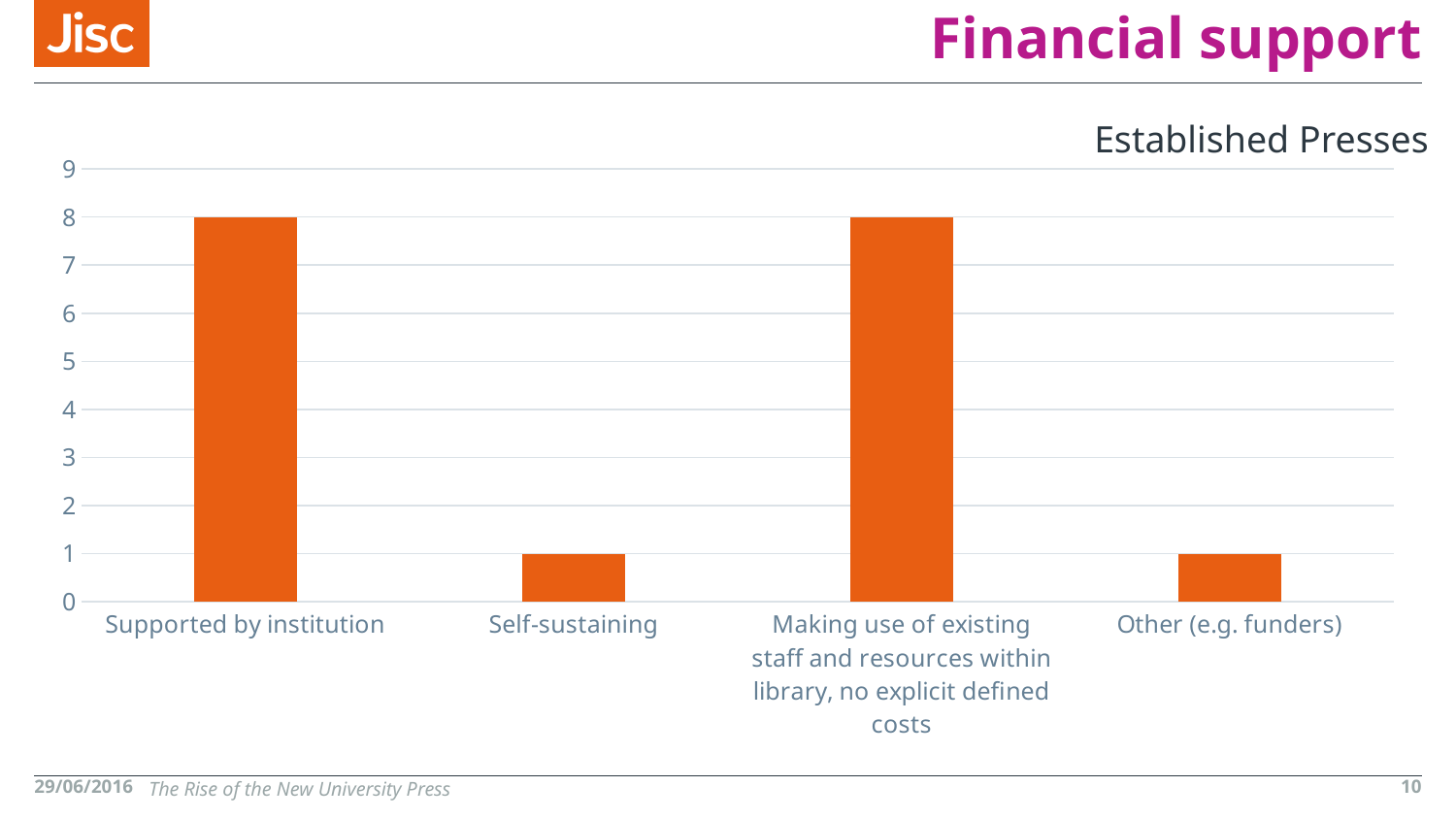
Which is larger, the value for Other (e.g. funders) or the value for Making use of existing staff and resources within library, no explicit defined costs? Making use of existing staff and resources within library, no explicit defined costs What is the value for Other (e.g. funders)? 1 Is the value for Other (e.g. funders) greater or less than 4? less What is the value for Self-sustaining? 1 Which is larger, the value for Supported by institution or the value for Self-sustaining? Supported by institution Is the value for Supported by institution greater or less than 5? greater What is the value for Making use of existing staff and resources within library, no explicit defined costs? 8 What is the value for Supported by institution? 8 What is the title of the chart? Established Presses What type of chart is shown on the slide? bar chart How many categories are shown on the x axis of the chart? 4 What is the difference between the value for Supported by institution and the value for Self-sustaining? 7